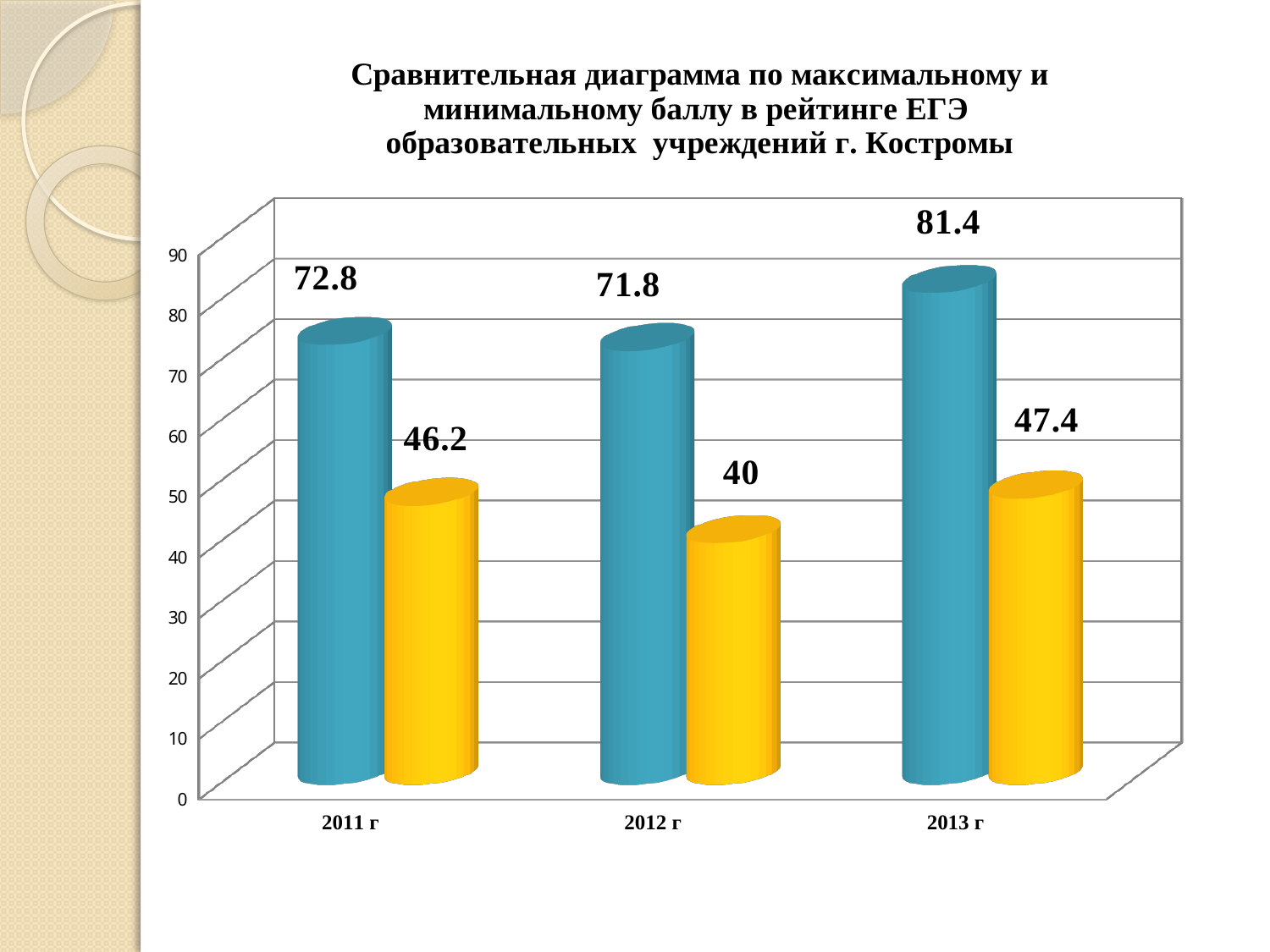
How many years are shown on the x axis? 3 What is the value of the yellow bar for 2012 г? 40 Which year has the larger blue bar value, 2011 г or 2012 г? 2011 г What is the value of the yellow bar for 2013 г? 47.4 Does the blue bar value rise or fall from 2012 г to 2013 г? rise What is the value of the blue bar for 2013 г? 81.4 In which year is the yellow bar the lowest? 2012 г What is the value of the blue bar for 2011 г? 72.8 What is the difference between the blue bar and the yellow bar for 2013 г? 34 In which year is the blue bar the highest? 2013 г What kind of chart is shown on the slide? bar chart What is the difference between the blue bar and the yellow bar for 2011 г? 26.6